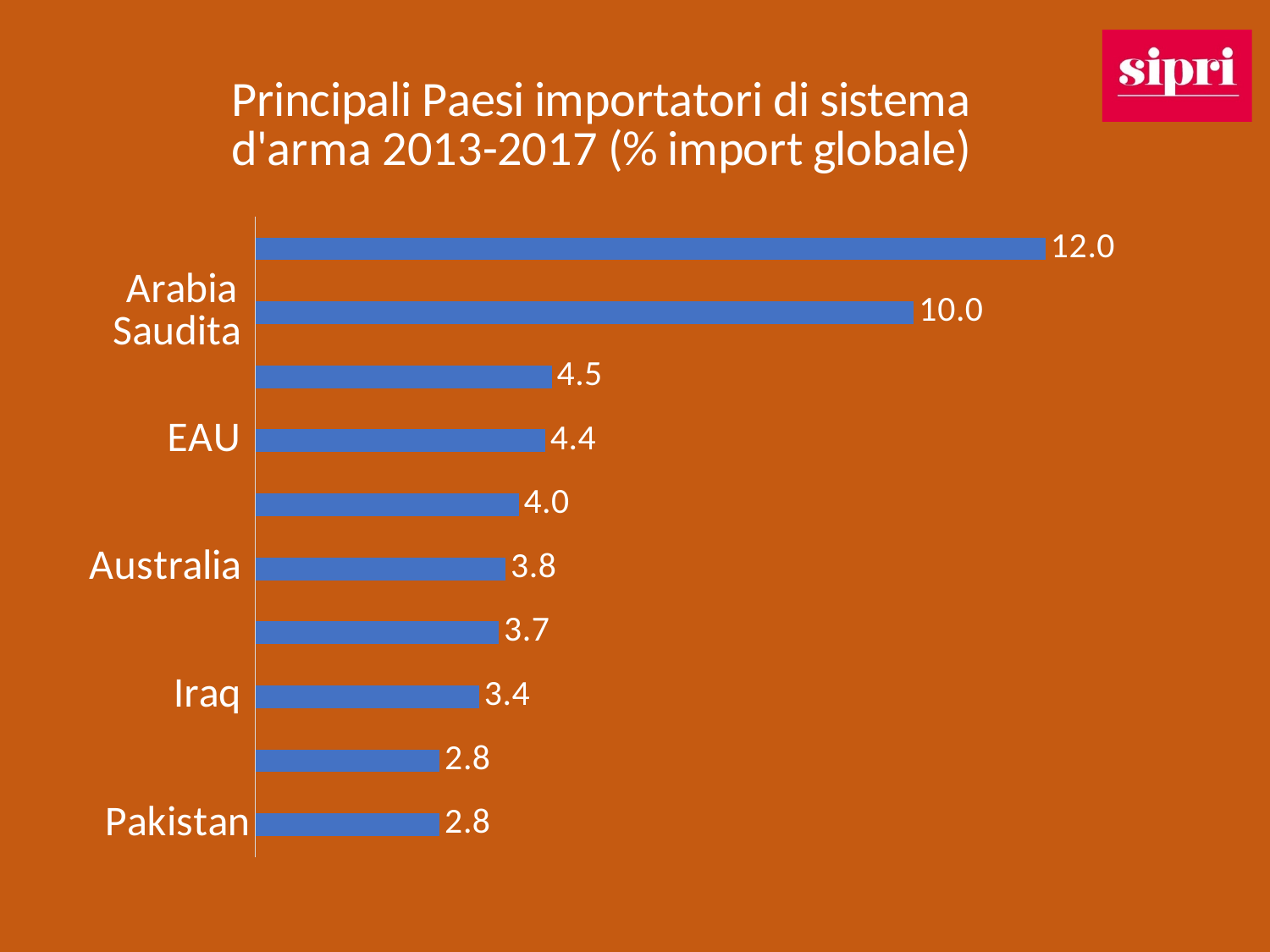
Among the labelled countries, which has the lowest value? Pakistan What is the highest value shown on the chart? 12.0 Do the bar values increase or decrease from the top of the chart to the bottom? Decrease Which is larger, the value for Australia or the value for Iraq? Australia What is the difference between the values for Arabia Saudita and EAU? 5.6 What is the value for Pakistan? 2.8 What is the value for Arabia Saudita? 10.0 What is the value for Iraq? 3.4 How many bars are plotted on the chart? 10 What kind of chart is shown on the slide? Bar chart What is the value for Australia? 3.8 What is the value for EAU? 4.4